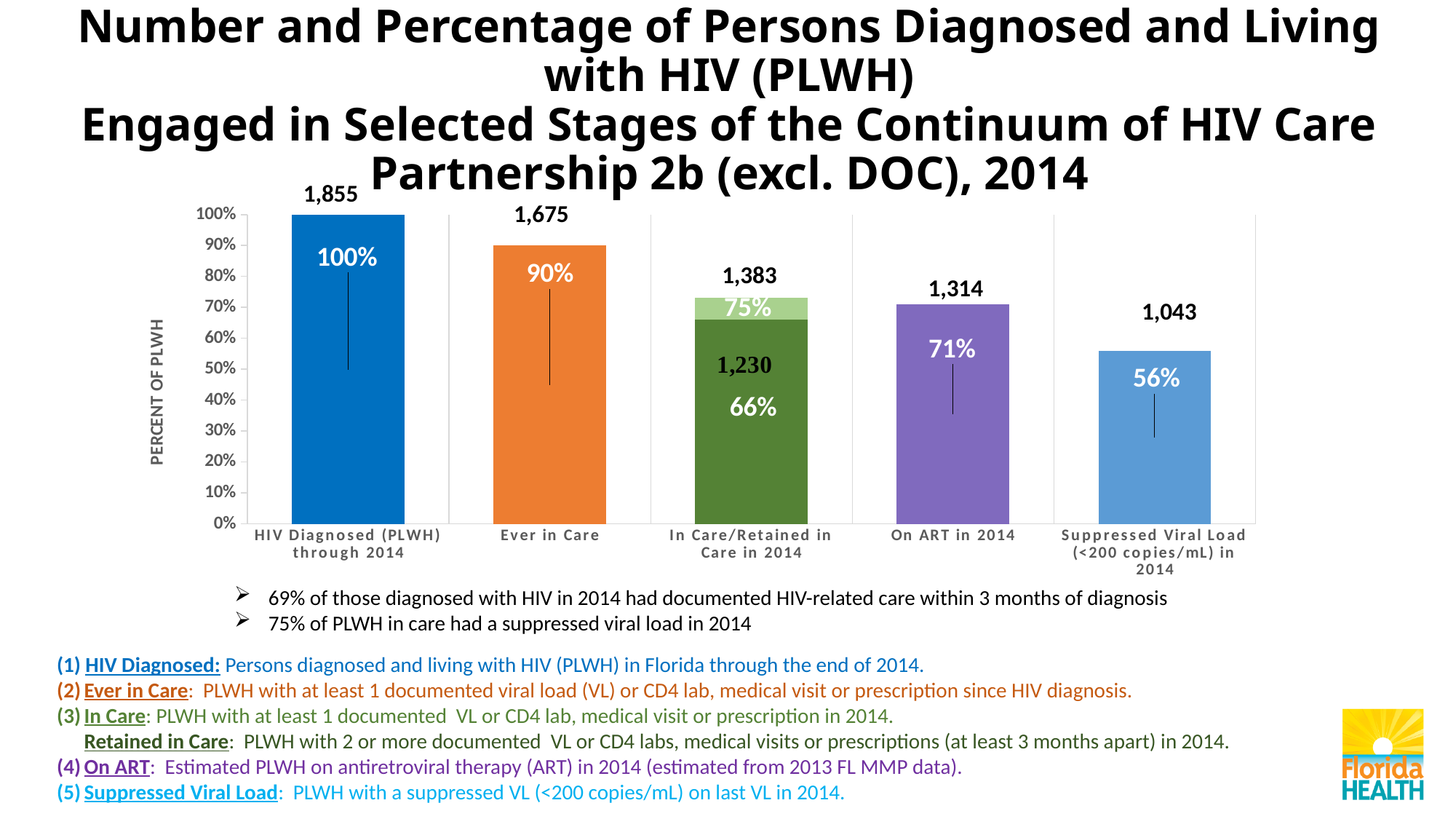
What percentage is shown on the 'Ever in Care' bar? 90% What is the number labelled on the 'On ART in 2014' bar? 1,314 How many categories are shown on the x axis of the chart? 5 What kind of chart is shown on the slide? bar chart What is the difference in number of persons between 'Ever in Care' (1,675) and 'On ART in 2014' (1,314)? 361 Which is larger, the percentage for 'On ART in 2014' or for 'Suppressed Viral Load (<200 copies/mL) in 2014'? On ART in 2014 Do the bar values rise or fall from left to right across the chart? fall What number is labelled for the retained-in-care (dark green) portion of the 'In Care/Retained in Care in 2014' bar? 1,230 What is the number of persons labelled on the 'HIV Diagnosed (PLWH) through 2014' bar? 1,855 Which category has the lowest value in the chart? Suppressed Viral Load (<200 copies/mL) in 2014 What percentage is shown on the 'Suppressed Viral Load (<200 copies/mL) in 2014' bar? 56% Which category has the highest value in the chart? HIV Diagnosed (PLWH) through 2014